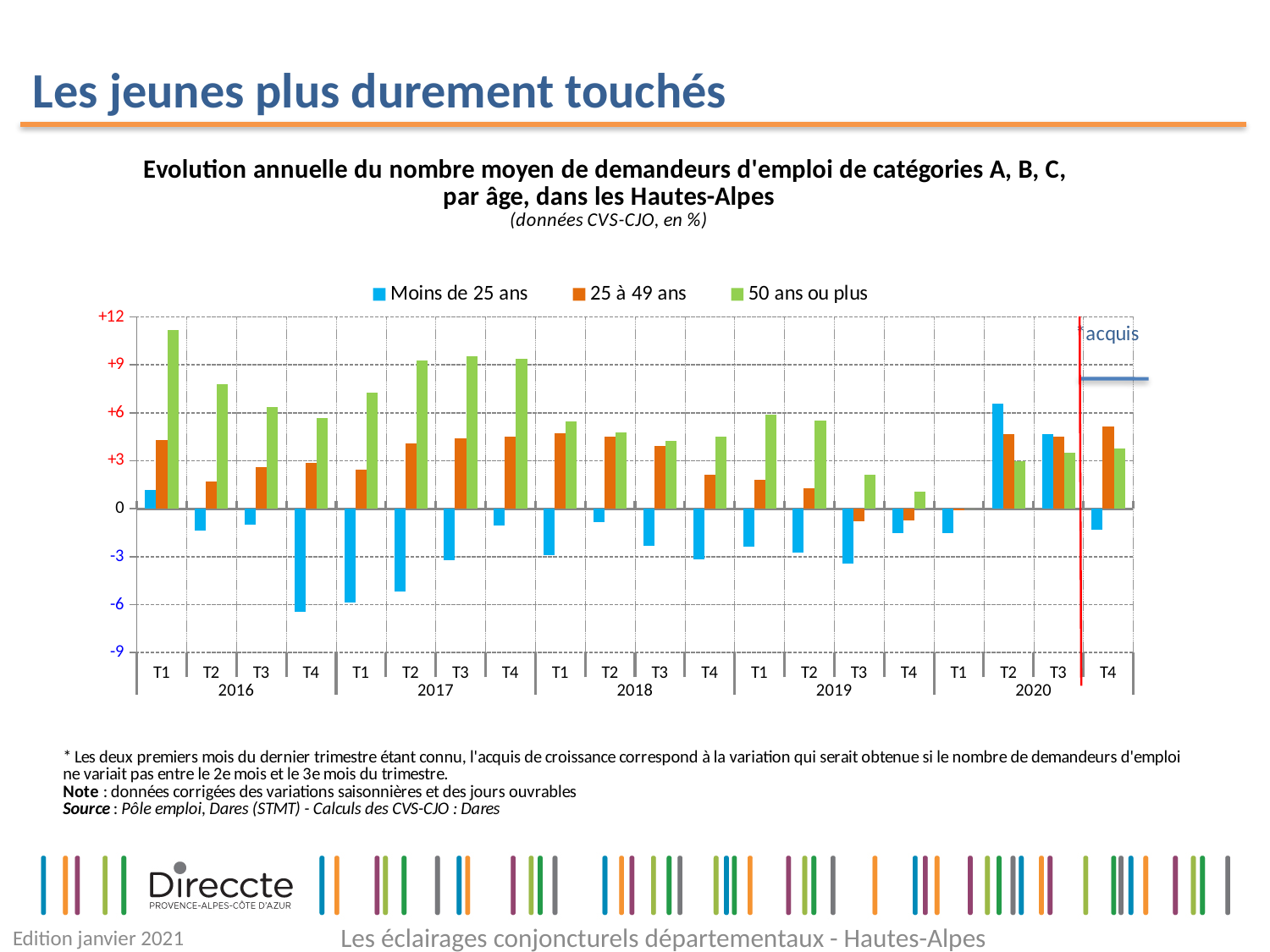
In which quarter is the value for 'Moins de 25 ans' the highest? T2 2020 In which quarter is the value for '50 ans ou plus' the highest? T1 2016 How many series does the legend list? 3 Do the values for '50 ans ou plus' rise or fall from T1 2016 to T4 2016? fall In T2 2020, which is larger: the value for 'Moins de 25 ans' or the value for '25 à 49 ans'? Moins de 25 ans Is the value for '50 ans ou plus' in T1 2016 greater or less than +9? greater How many quarters (T1–T4 across the years) are plotted on the x axis? 20 In T1 2016, which is larger: the value for '50 ans ou plus' or the value for '25 à 49 ans'? 50 ans ou plus Is the value for 'Moins de 25 ans' in T1 2017 greater or less than -3? less Is the value for '25 à 49 ans' in T4 2020 greater or less than +3? greater What kind of chart is shown on the slide? Bar chart What are the three series named in the legend? Moins de 25 ans, 25 à 49 ans, 50 ans ou plus